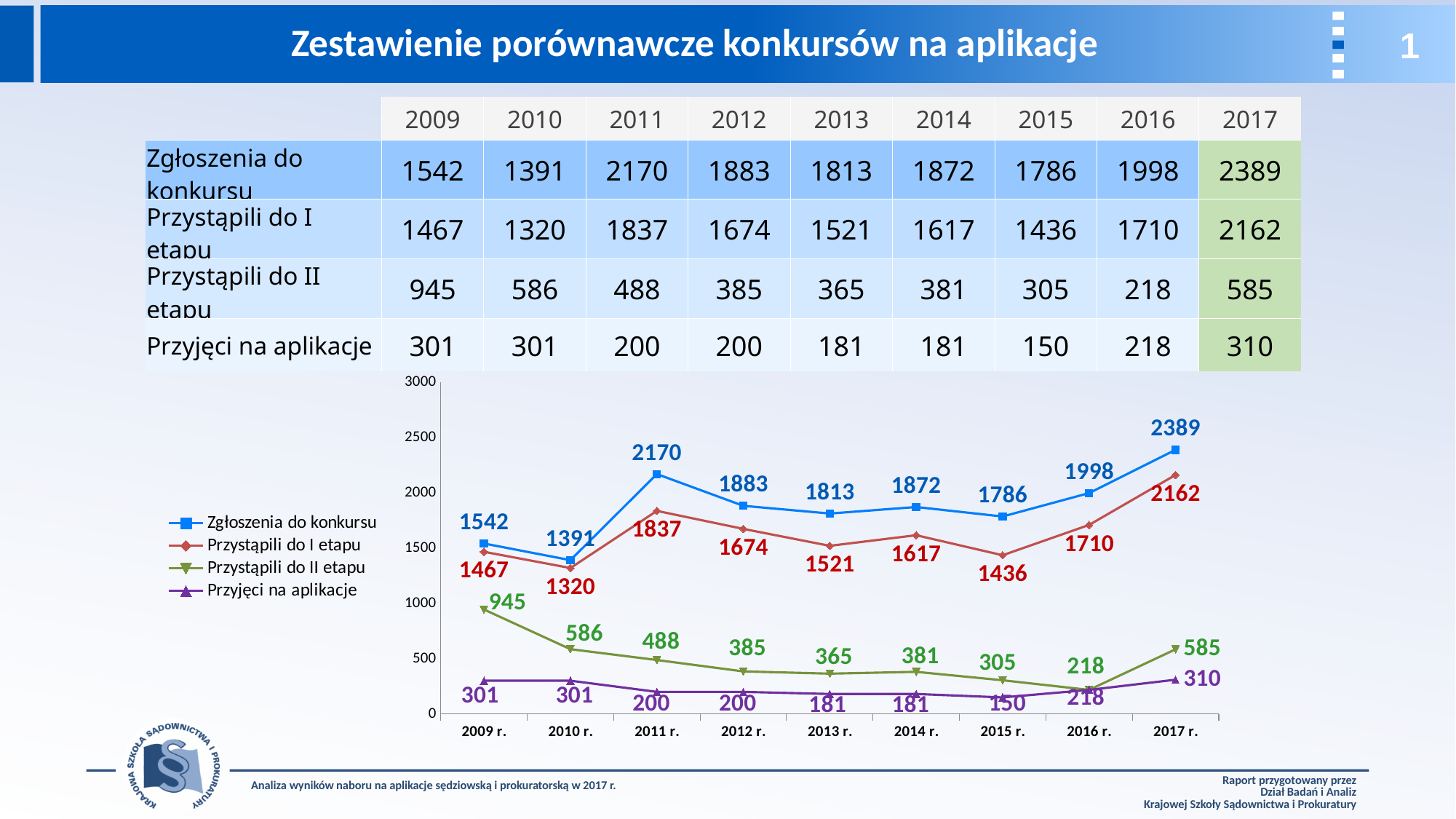
What is the value for Przystąpili do I etapu in 2015 r.? 1436 Which is larger for Przystąpili do II etapu: the value in 2009 r. or in 2017 r.? 2009 r. How many years are plotted on the x axis? 9 What kind of chart is shown on the slide? line chart What is the value for Zgłoszenia do konkursu in 2011 r.? 2170 In which year is Zgłoszenia do konkursu highest? 2017 r. What is the difference between Przystąpili do II etapu in 2009 r. and in 2010 r.? 359 How many series does the legend list? 4 What is the difference between Zgłoszenia do konkursu and Przystąpili do I etapu in 2017 r.? 227 What is the value for Przystąpili do II etapu in 2013 r.? 365 In which year is Przyjęci na aplikacje lowest? 2015 r. Does Przystąpili do II etapu rise or fall from 2009 r. to 2016 r.? fall